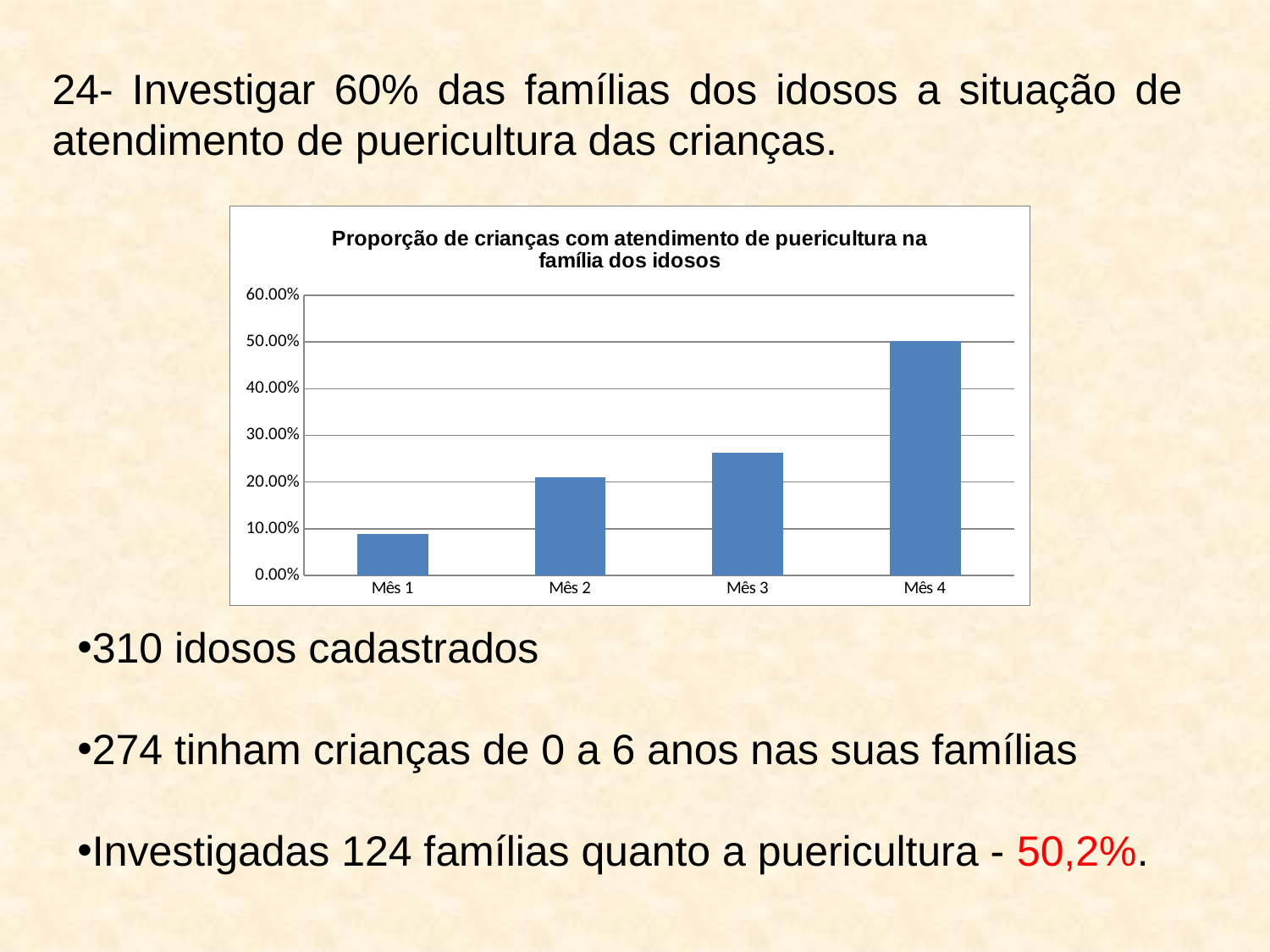
Is the value for Mês 4 greater or less than 40.00%? greater What is the title of the chart? Proporção de crianças com atendimento de puericultura na família dos idosos Which is larger, the value for Mês 2 or the value for Mês 4? Mês 4 Which month has the highest bar in the chart? Mês 4 How many categories (months) are shown on the x axis of the chart? 4 What is the highest value shown on the y axis of the chart? 60.00% Is the value for Mês 3 greater or less than 30.00%? less Is the value for Mês 1 greater or less than 10.00%? less Do the values rise or fall from Mês 1 to Mês 4? rise Which month has the lowest bar in the chart? Mês 1 What type of chart is shown on the slide? bar chart